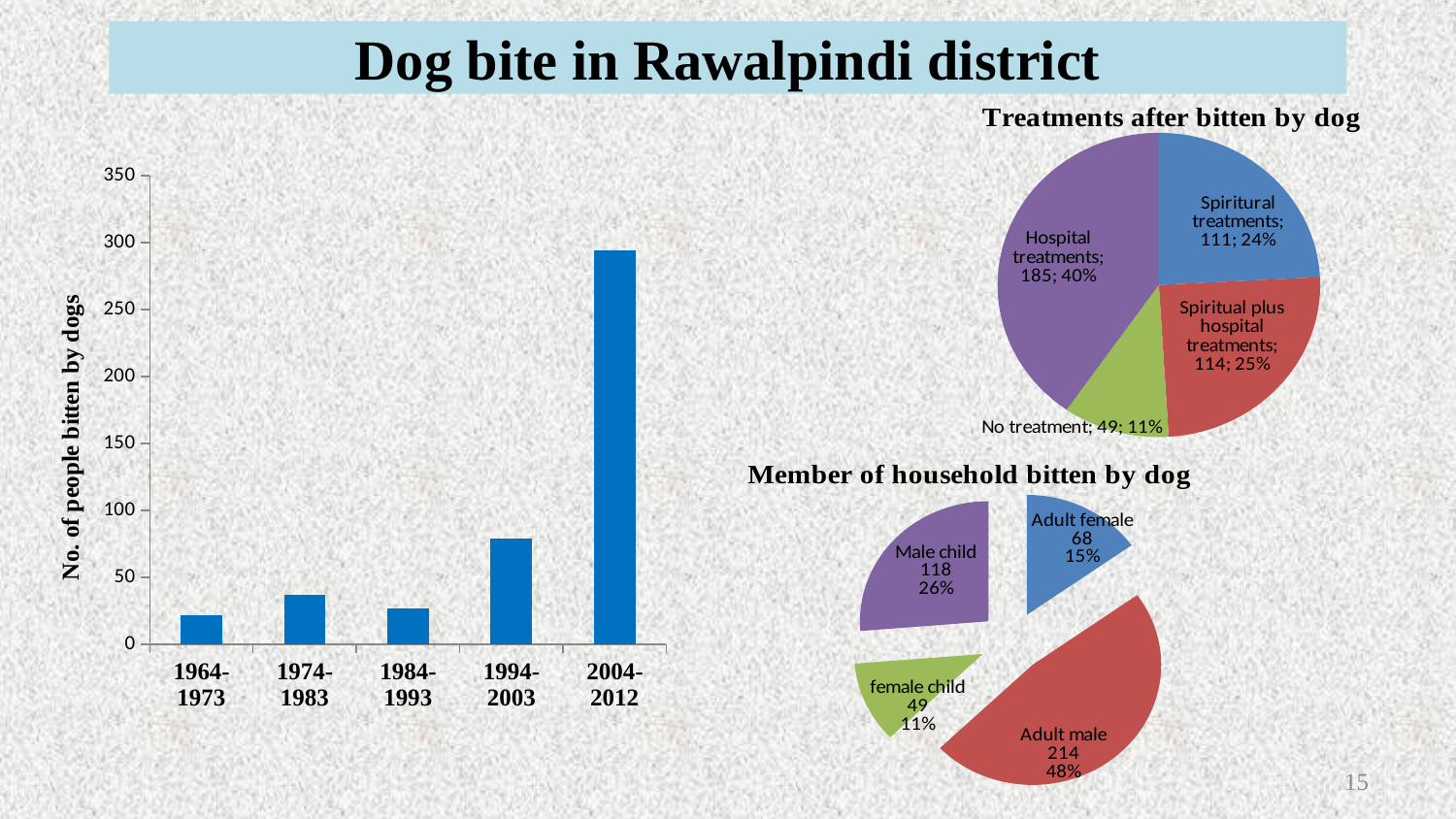
In the 'Treatments after bitten by dog' pie chart, what is the difference between the number receiving spiritual plus hospital treatments and the number receiving spiritual treatments? 3 In the bar chart on the left, is the value for 2004-2012 greater or less than 250? greater In the 'Member of household bitten by dog' pie chart, which member of household has the largest number of dog bites? Adult male In the bar chart on the left, which period has the lowest number of people bitten by dogs? 1964-1973 In the bar chart on the left, how many time periods are shown on the x axis? 5 What type of chart is the chart on the left of the slide? bar chart In the 'Member of household bitten by dog' pie chart, which is larger, Adult female or female child? Adult female In the 'Member of household bitten by dog' pie chart, what is the value for Male child? 118 In the 'Treatments after bitten by dog' pie chart, how many people received hospital treatments? 185 In the 'Treatments after bitten by dog' pie chart, what share of the pie is 'No treatment'? 11% In the bar chart on the left, is the value for 1994-2003 greater or less than 100? less In the bar chart on the left, which period has the highest number of people bitten by dogs? 2004-2012